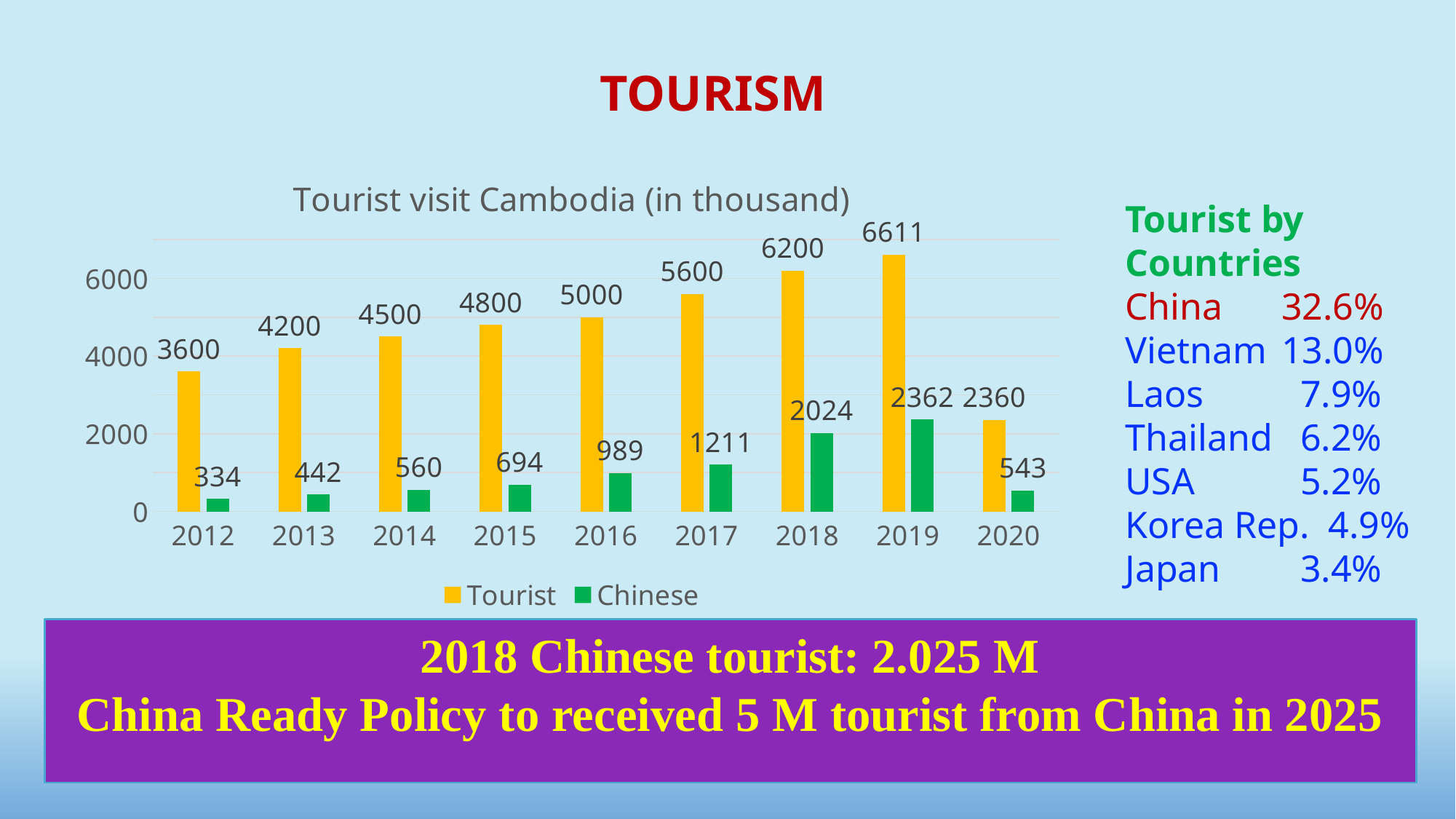
What is the difference between the Tourist value and the Chinese value in 2019? 4249 Is the Tourist value for 2016 greater or less than 4000? greater Which year has the highest Tourist value? 2019 Which is larger, the Chinese value for 2018 or the Chinese value for 2020? 2018 What is the Tourist value for 2017? 5600 What is the title of the chart? Tourist visit Cambodia (in thousand) Which year has the lowest Chinese value? 2012 How many years are shown on the x axis? 9 Do the Tourist values rise or fall from 2012 to 2019? rise What is the Chinese value for 2015? 694 How many series does the legend list? 2 What kind of chart is shown? bar chart